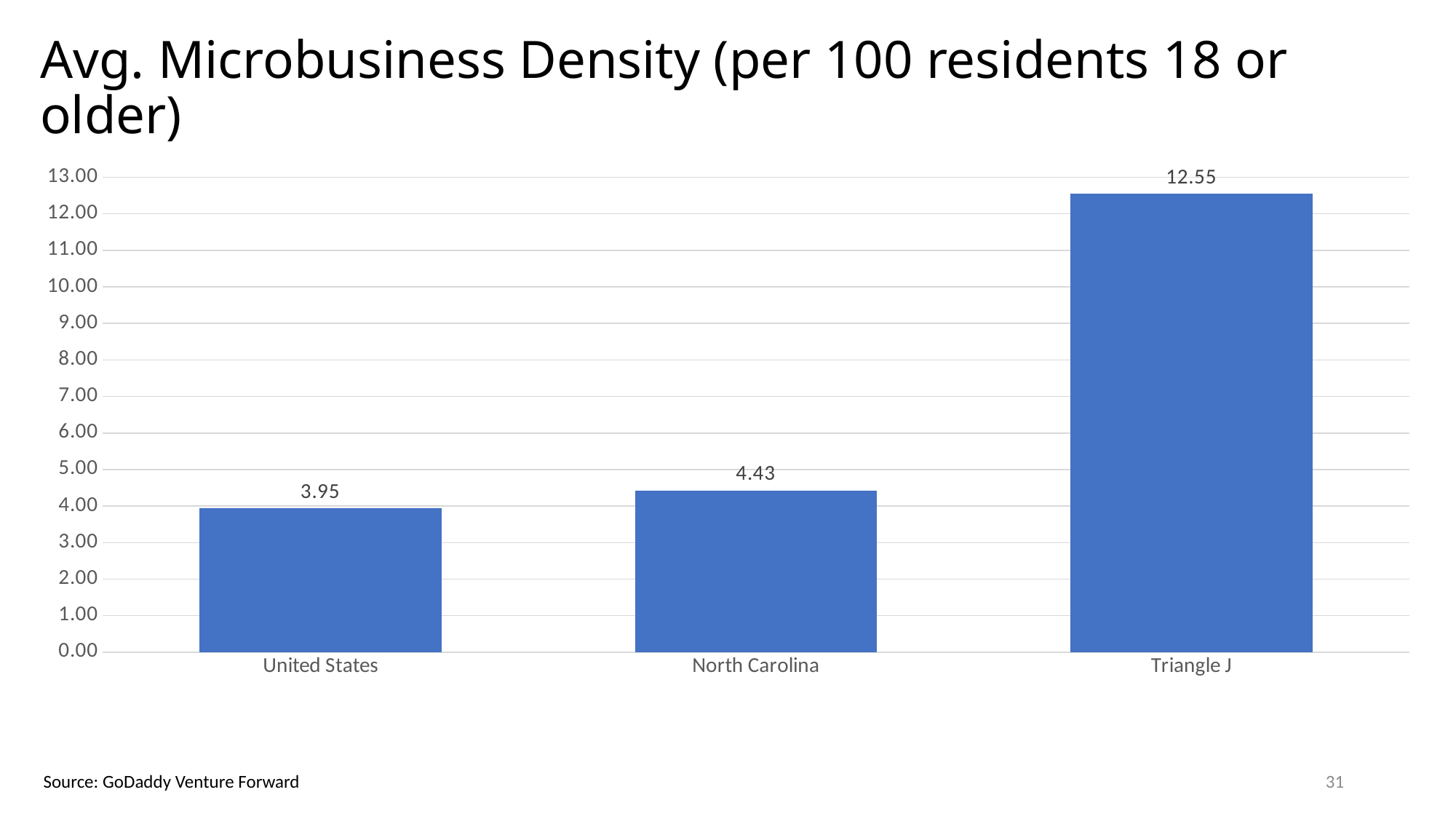
What is the average microbusiness density for the United States? 3.95 How many categories are shown on the chart? 3 Which category has the highest average microbusiness density? Triangle J What is the average microbusiness density for Triangle J? 12.55 What kind of chart is shown on the slide? bar chart What is the source cited for the chart? GoDaddy Venture Forward Is the value for Triangle J greater or less than 10.00? greater What is the difference between the Triangle J value and the North Carolina value? 8.12 Which is larger, the value for North Carolina or the value for United States? North Carolina What is the average microbusiness density for North Carolina? 4.43 Which category has the lowest average microbusiness density? United States What is the difference between the North Carolina value and the United States value? 0.48